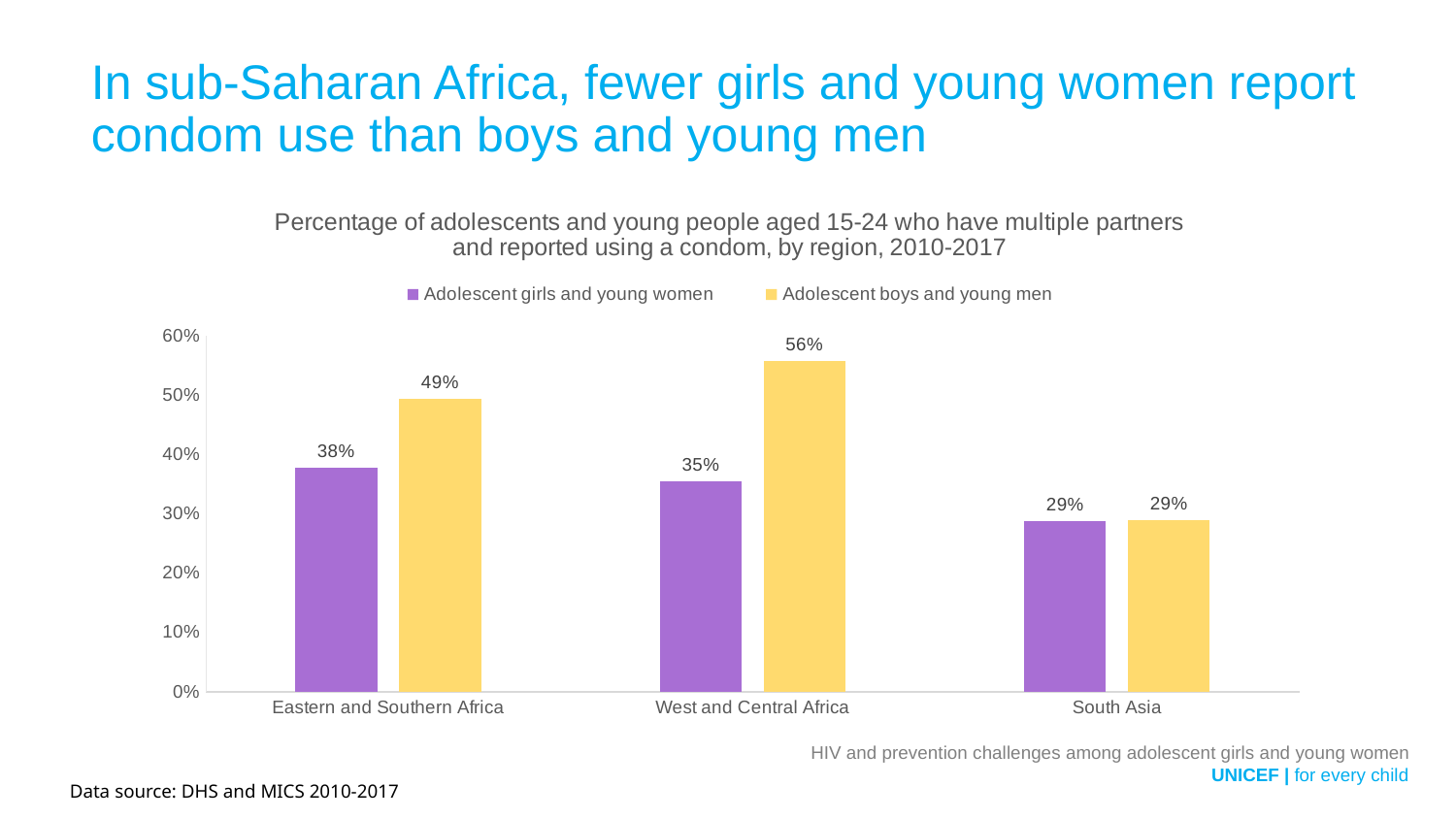
Which colour represents adolescent boys and young men in the chart? Yellow What is the value for adolescent boys and young men in Eastern and Southern Africa? 49% Which region has the lowest value for adolescent girls and young women? South Asia What kind of chart is shown on the slide? Bar chart Which region has the highest value for adolescent boys and young men? West and Central Africa How many regions are shown on the x axis? 3 What percentage of adolescent girls and young women in Eastern and Southern Africa reported using a condom? 38% What is the value for adolescent girls and young women in South Asia? 29% In Eastern and Southern Africa, which group has the larger value: adolescent girls and young women or adolescent boys and young men? Adolescent boys and young men How many series does the legend list? 2 What percentage of adolescent boys and young men in West and Central Africa reported using a condom? 56% What is the difference between adolescent boys and young men and adolescent girls and young women in West and Central Africa? 21 percentage points